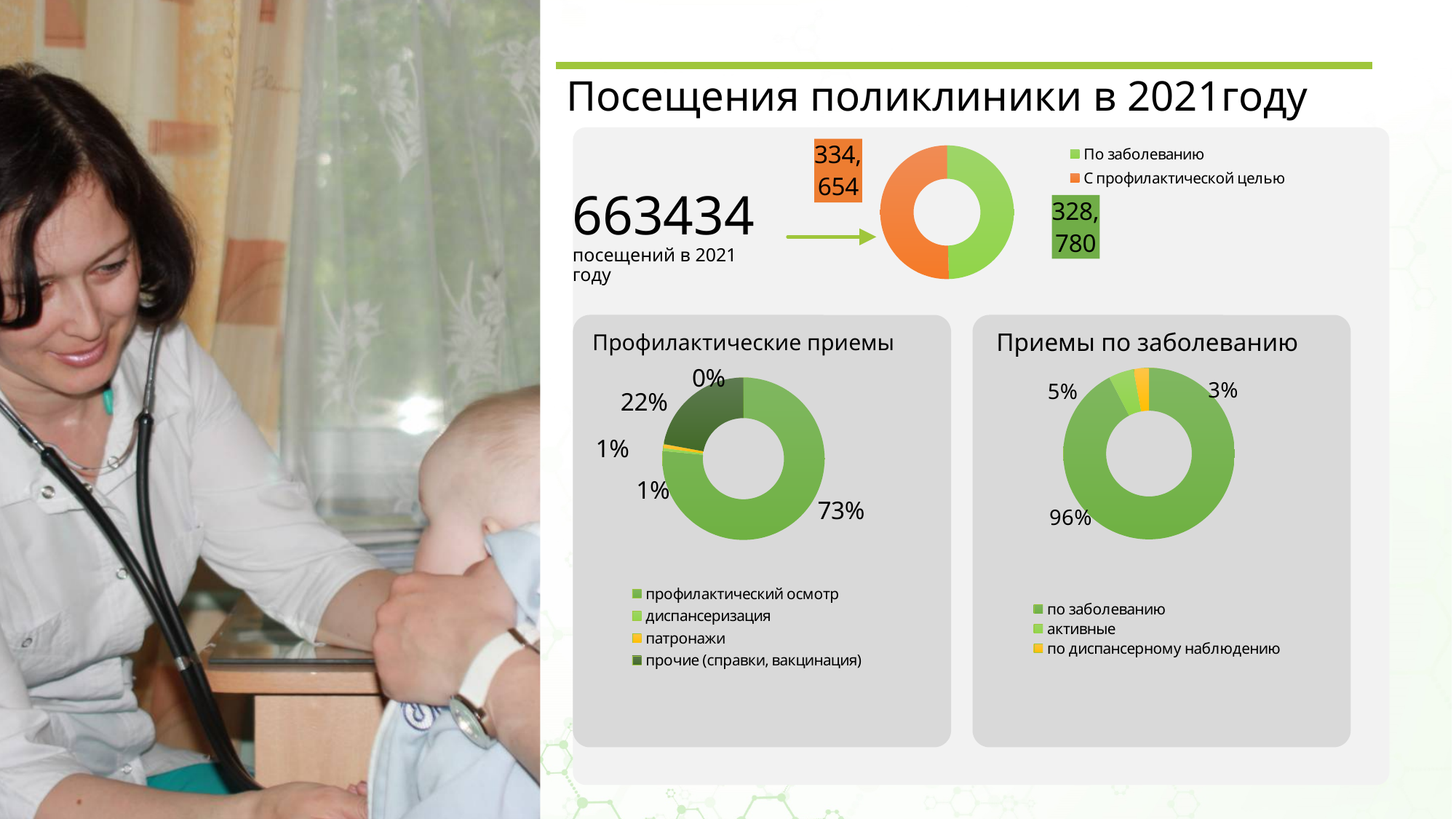
On the 'Профилактические приемы' chart, which category has the largest share? профилактический осмотр On the top chart, what value is shown for 'По заболеванию'? 328,780 How many entries does the legend of the 'Профилактические приемы' chart list? 4 On the top chart, what value is shown for 'С профилактической целью'? 334,654 On the 'Профилактические приемы' chart, what share is 'прочие (справки, вакцинация)'? 22% On the 'Приемы по заболеванию' chart, what share is 'по диспансерному наблюдению'? 3% What is the total number of visits in 2021 stated next to the top chart? 663434 What kind of chart is the 'Приемы по заболеванию' chart? Doughnut chart On the 'Профилактические приемы' chart, what share is 'профилактический осмотр'? 73% How many series does the legend of the top chart list? 2 On the top chart, which is larger: 'По заболеванию' or 'С профилактической целью'? С профилактической целью